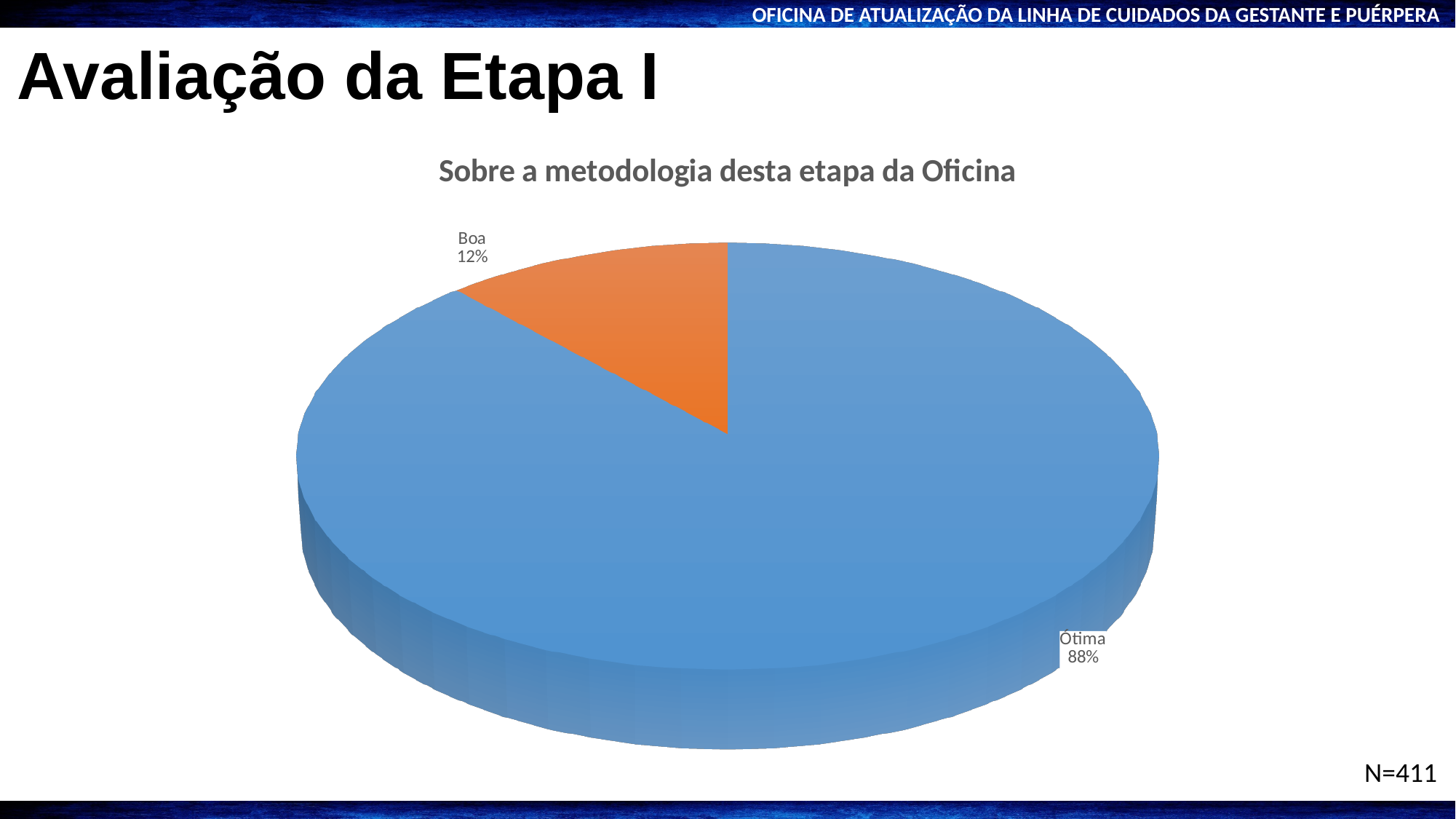
Which slice is larger, "Boa" or "Ótima"? Ótima What is the share of the pie taken by the "Ótima" slice? 88% Which slice is the smallest in the pie chart? Boa How many slices does the pie chart have? 2 What is the difference in percentage points between the "Ótima" and "Boa" slices? 76 What colour is the "Boa" slice? orange What percentage of the pie is labelled "Ótima"? 88% What kind of chart is shown on the slide? pie chart Which slice is the largest in the pie chart? Ótima What percentage of the pie is labelled "Boa"? 12% What is the title of the chart? Sobre a metodologia desta etapa da Oficina